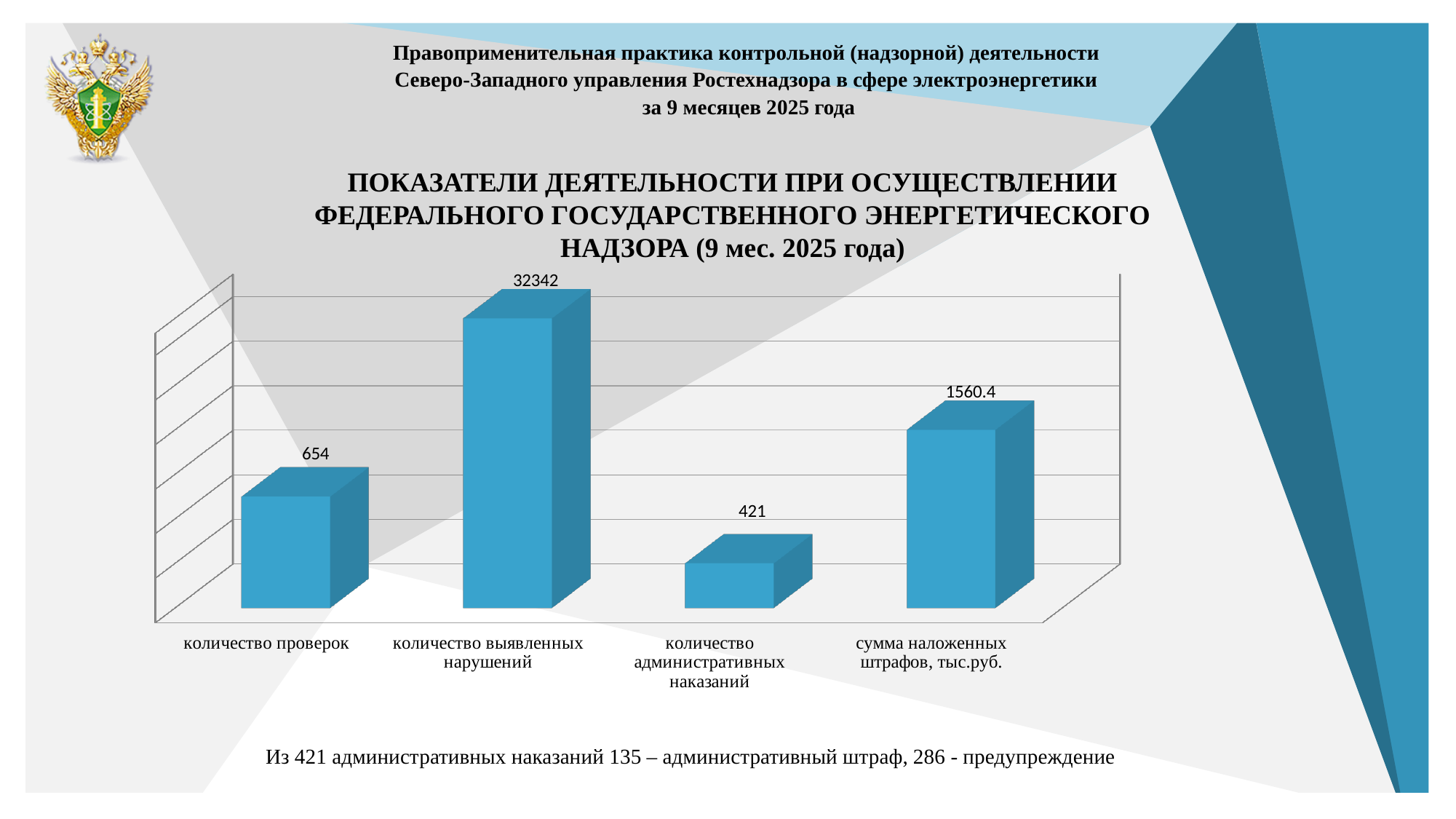
What period does the chart title say the indicators cover? 9 мес. 2025 года Which category has the lowest value? количество административных наказаний Which category has the highest value? количество выявленных нарушений What is the value for "сумма наложенных штрафов, тыс.руб."? 1560.4 What is the value for "количество административных наказаний"? 421 How many categories are shown in the chart? 4 Which is larger: the value for "количество проверок" or the value for "количество административных наказаний"? количество проверок What kind of chart is shown on the slide? bar chart What is the value for "количество проверок"? 654 What is the value for "количество выявленных нарушений"? 32342 What is the difference between the value for "количество выявленных нарушений" and the value for "количество проверок"? 31688 What is the difference between the value for "количество проверок" and the value for "количество административных наказаний"? 233